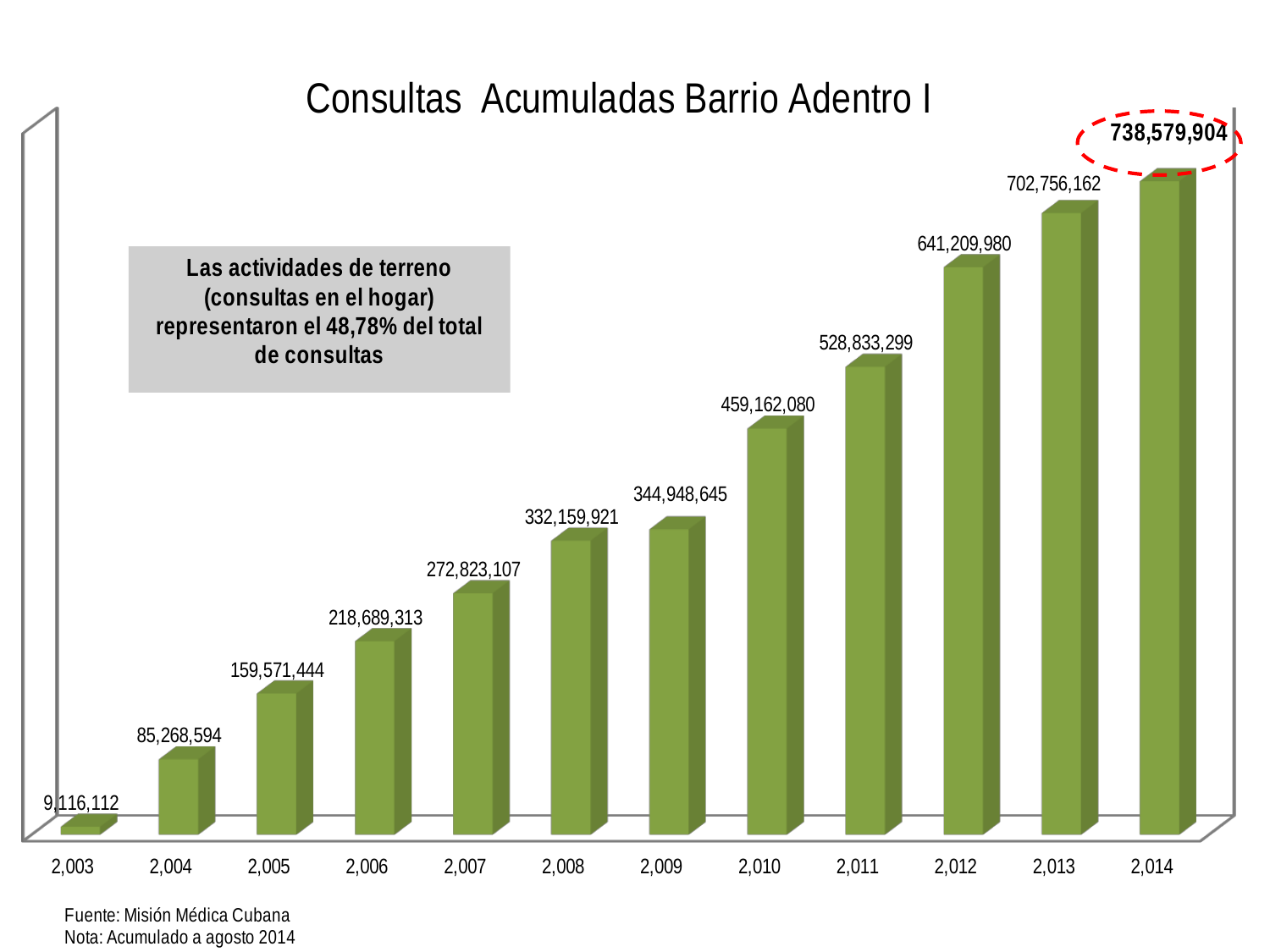
Which year has the highest value? 2,014 Which is larger, the value for 2,011 or the value for 2,010? 2,011 What is the value shown for 2,005? 159,571,444 What is the difference between the values for 2,014 and 2,013? 35,823,742 What is the value shown for 2,010? 459,162,080 What kind of chart is this? Bar chart How many years are shown on the x axis? 12 Do the values rise or fall from 2,003 to 2,014? Rise What is the value shown for 2,014? 738,579,904 What is the difference between the values for 2,009 and 2,008? 12,788,724 Which year has the lowest value? 2,003 What is the value shown for 2,003? 9,116,112